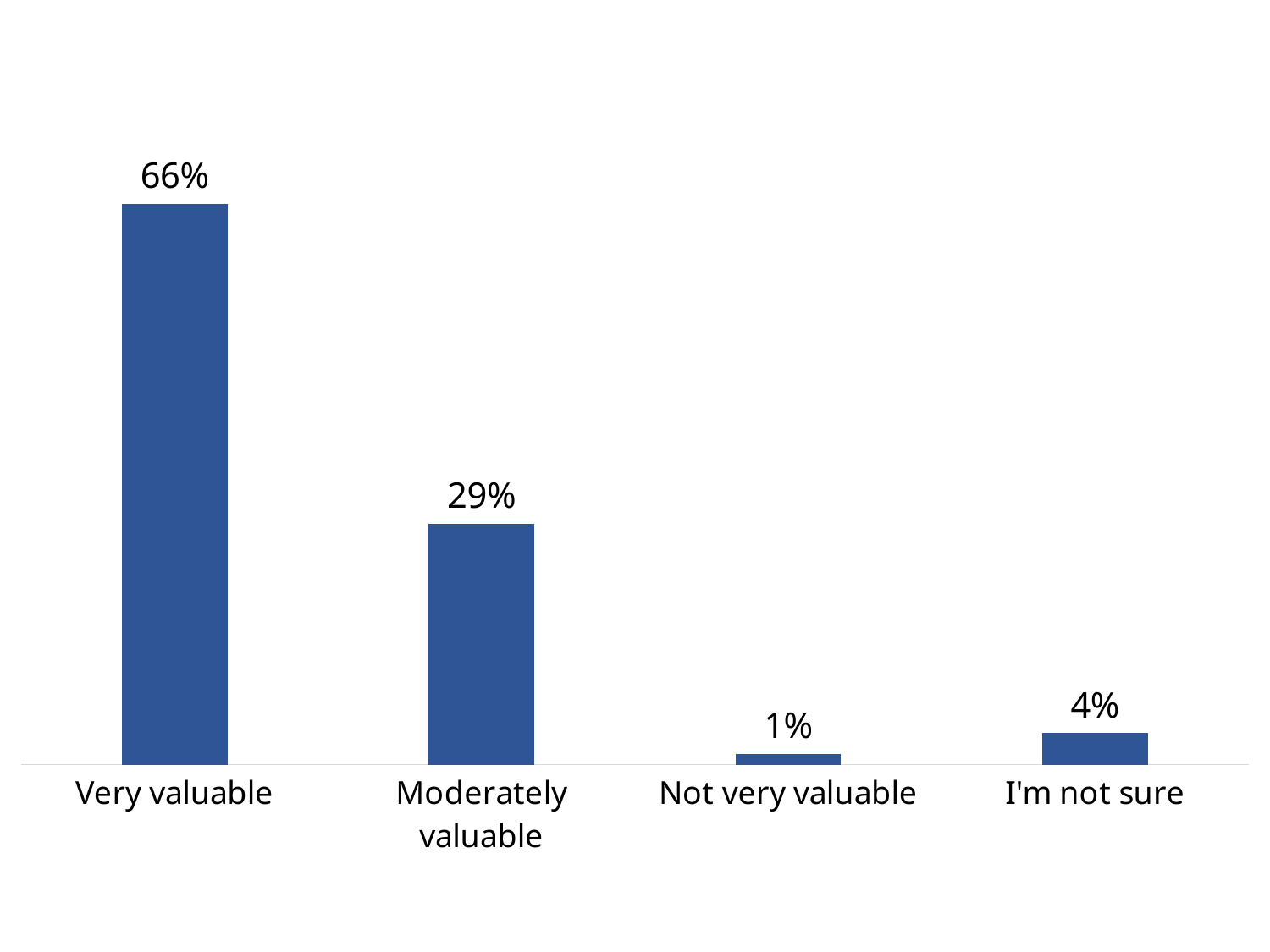
What is the value for Not very valuable? 1% Which category has the lowest value? Not very valuable What is the difference between the values for Very valuable and Moderately valuable? 37% Which category has the highest value? Very valuable What is the value for Very valuable? 66% How many categories are shown in the chart? 4 What kind of chart is this? Bar chart What colour are the bars in the chart? Blue What is the value for I'm not sure? 4% What is the value for Moderately valuable? 29% What is the difference between the values for I'm not sure and Not very valuable? 3% Which is larger, the value for I'm not sure or the value for Not very valuable? I'm not sure